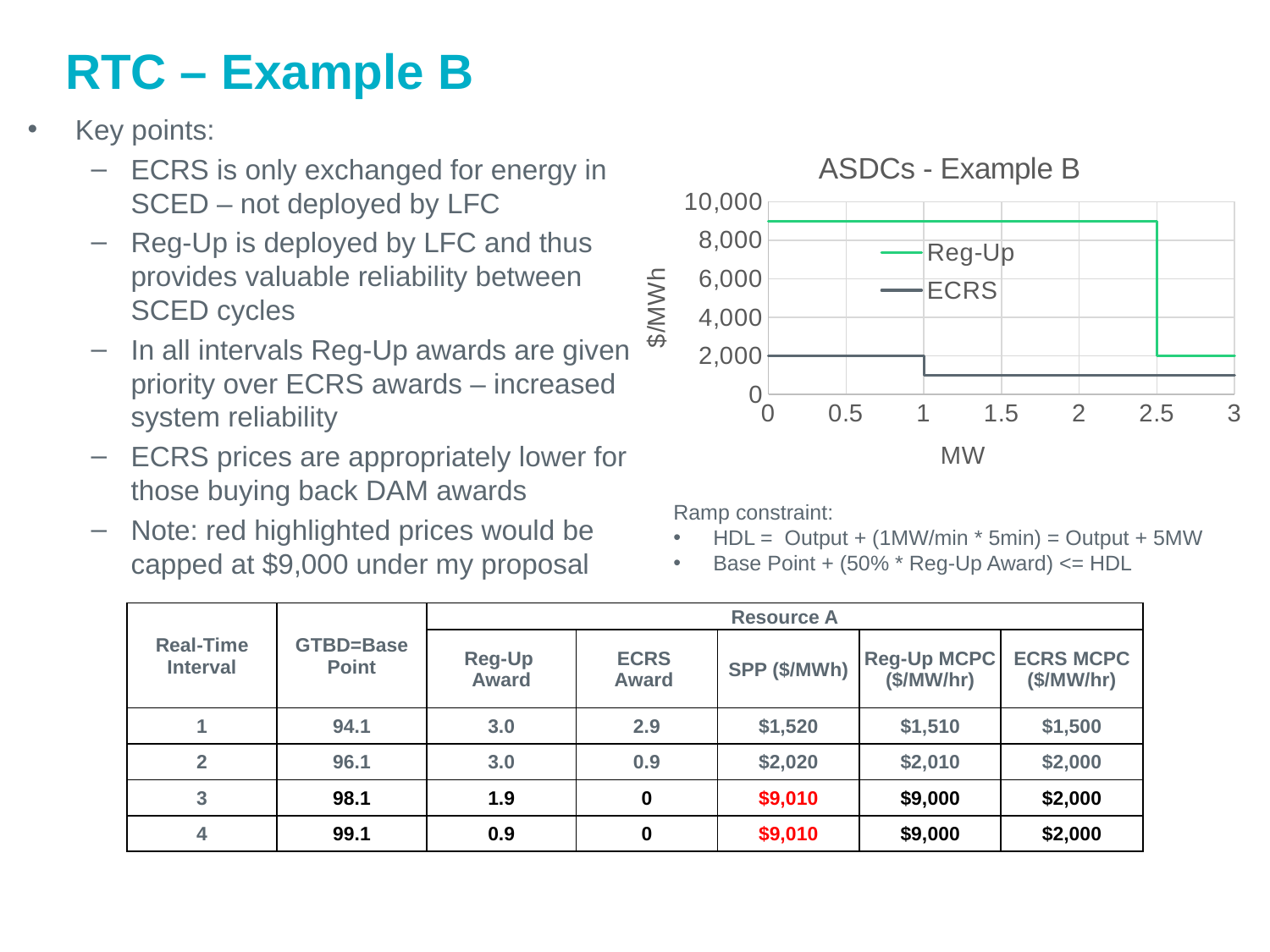
What is the title of the chart? ASDCs - Example B What is the label of the x axis of the chart? MW Is the ECRS value at 2 MW greater or less than 2,000? less How many series does the chart legend list? 2 At 2 MW, which series has the higher value, Reg-Up or ECRS? Reg-Up What kind of chart is shown on the slide? line chart Which series are listed in the chart legend? Reg-Up and ECRS Is the ECRS value at 0.5 MW greater or less than 4,000? less Do the ECRS values rise or fall as MW increases along the x axis? fall Is the Reg-Up value at 1 MW greater or less than 8,000? greater Do the Reg-Up values rise or fall as MW increases along the x axis? fall